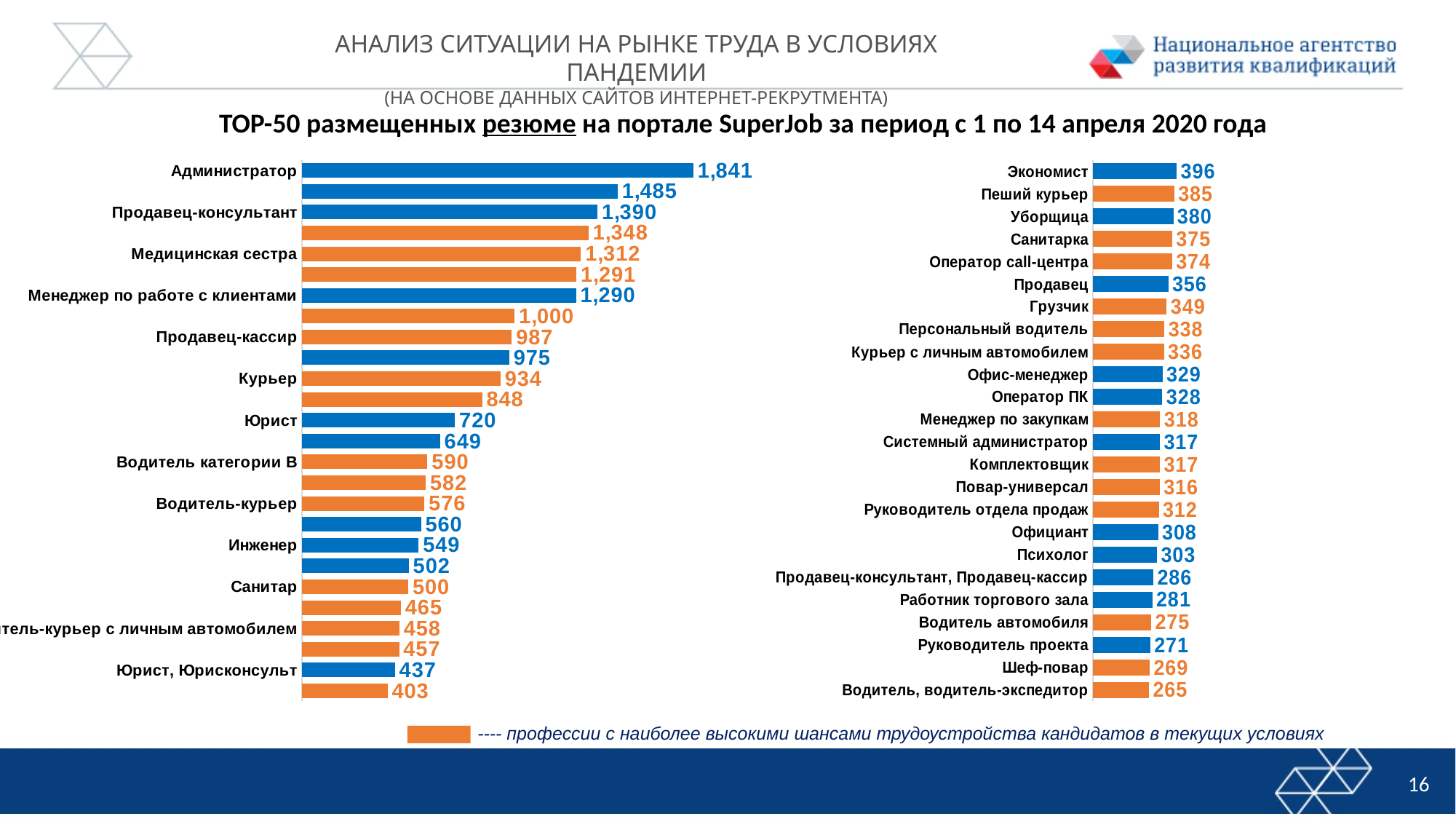
On the right chart, what is the difference between the values for Экономист and Шеф-повар? 127 On the right chart, which category has the lowest value? Водитель, водитель-экспедитор On the left chart, what is the value for Медицинская сестра? 1,312 On the left chart, what is the difference between the values for Администратор and Продавец-консультант? 451 On the right chart, what is the value for Официант? 308 On the right chart, what is the value for Экономист? 396 On the left chart, which category has the highest value? Администратор On the left chart, which is larger: the value for Курьер or the value for Юрист? Курьер On the left chart, what is the value for Администратор? 1,841 How many categories are plotted on the right chart? 24 What kind of chart is shown on the left of the slide? Bar chart According to the legend at the bottom, what do the orange bars represent? Профессии с наиболее высокими шансами трудоустройства кандидатов в текущих условиях